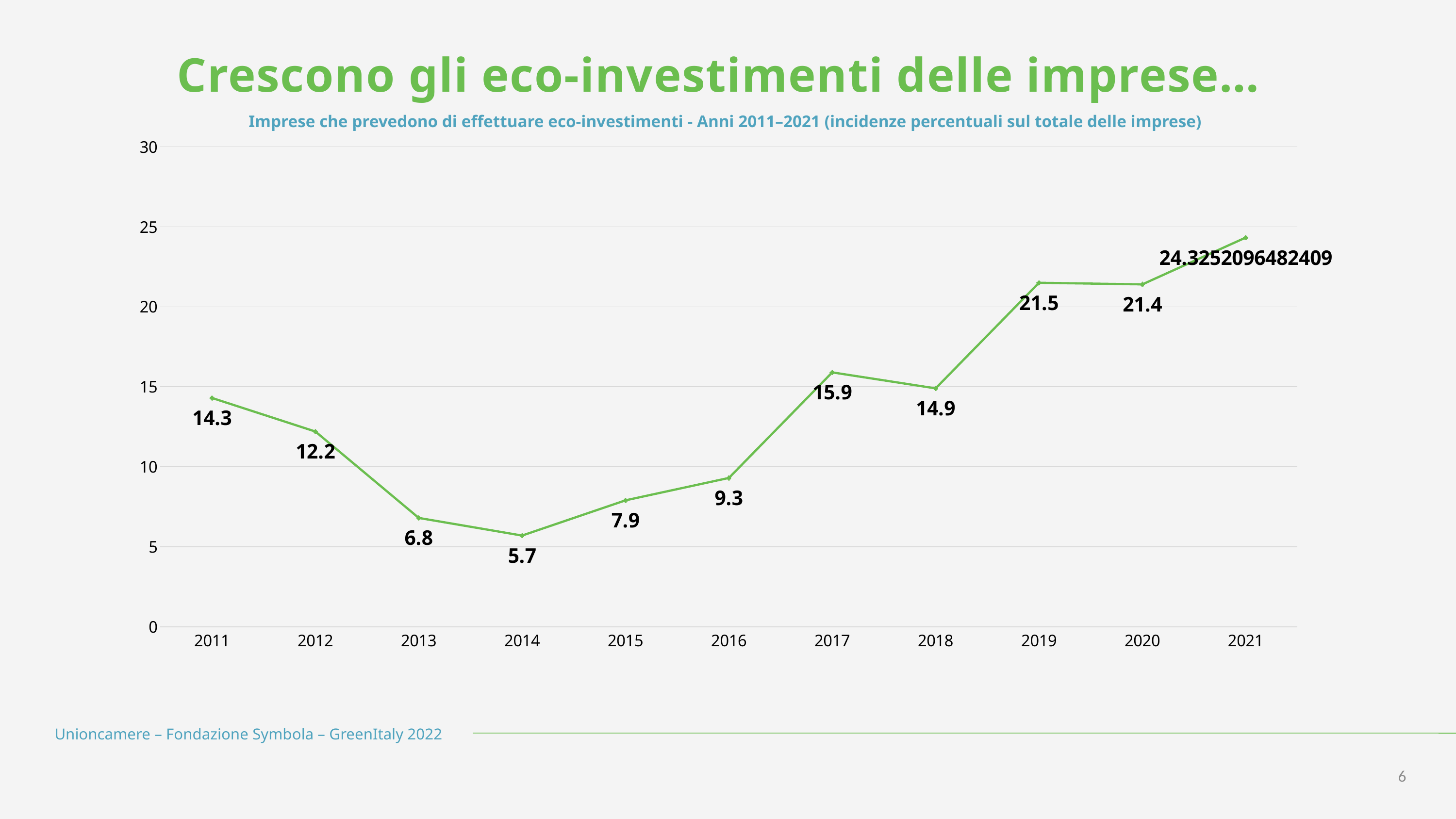
What is the difference between the values for 2011 and 2012? 2.1 Do the values rise or fall from 2014 to 2017? Rise What is the value for 2019? 21.5 What is the difference between the values for 2019 and 2018? 6.6 How many years are plotted on the chart? 11 Which is larger, the value for 2017 or the value for 2018? 2017 What is the value for 2011? 14.3 What kind of chart is shown on the slide? Line chart Which year has the highest value? 2021 Which year has the lowest value? 2014 What is the value for 2014? 5.7 Is the value for 2021 greater or less than 20? greater